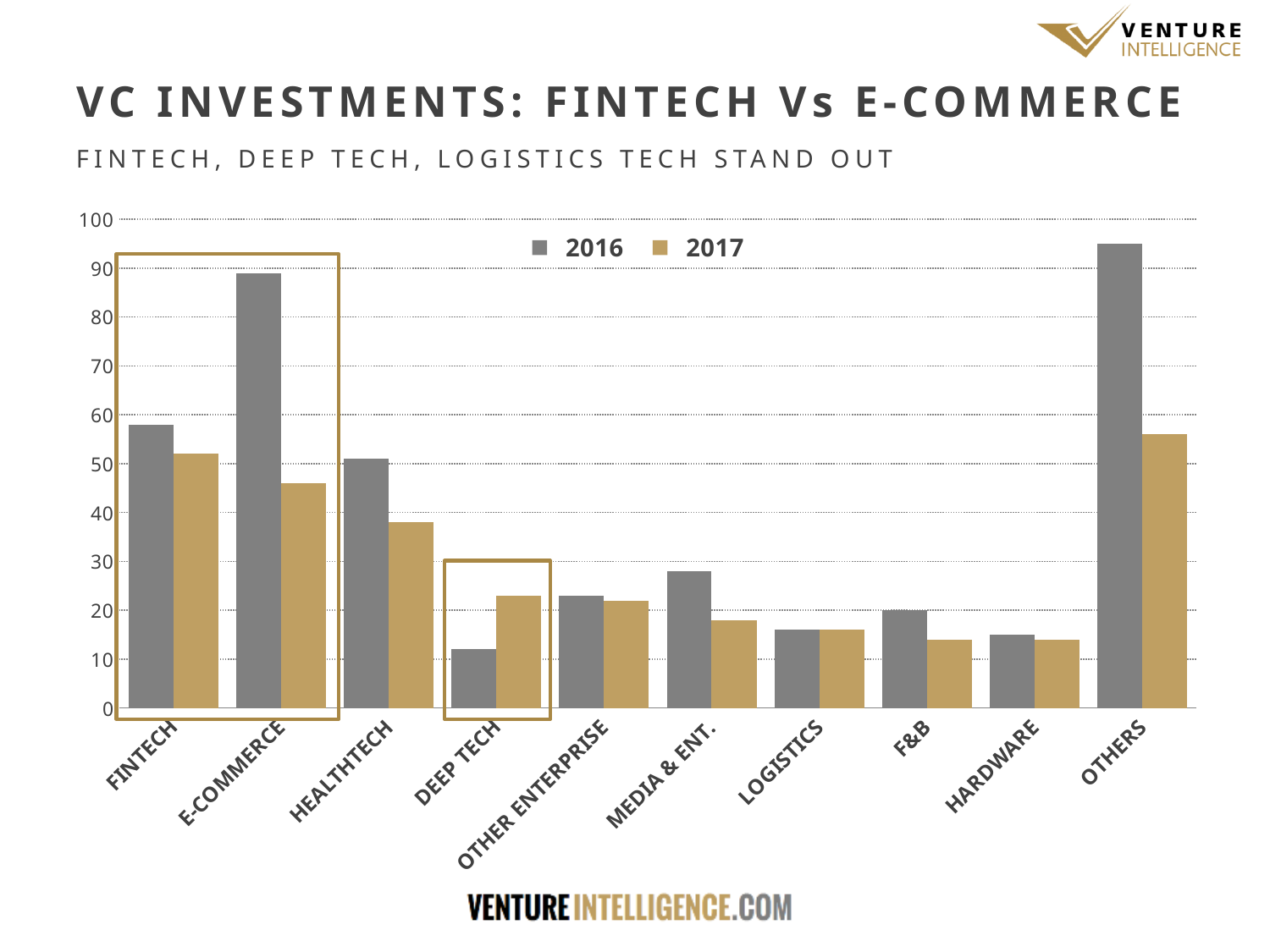
What is the title of the chart on the slide? VC INVESTMENTS: FINTECH Vs E-COMMERCE How many categories are shown on the x axis? 10 Which category has the highest 2017 value? OTHERS Is the 2016 value for E-COMMERCE greater or less than 80? greater Which category has the highest 2016 value? OTHERS Which is larger, the 2016 value for E-COMMERCE or the 2016 value for FINTECH? E-COMMERCE What kind of chart is shown on the slide? bar chart Is the 2016 value for DEEP TECH greater or less than 20? less For DEEP TECH, which is larger, the 2016 value or the 2017 value? 2017 How many series does the legend list? 2 Which category has the lowest 2016 value? DEEP TECH Is the 2017 value for HEALTHTECH greater or less than 30? greater